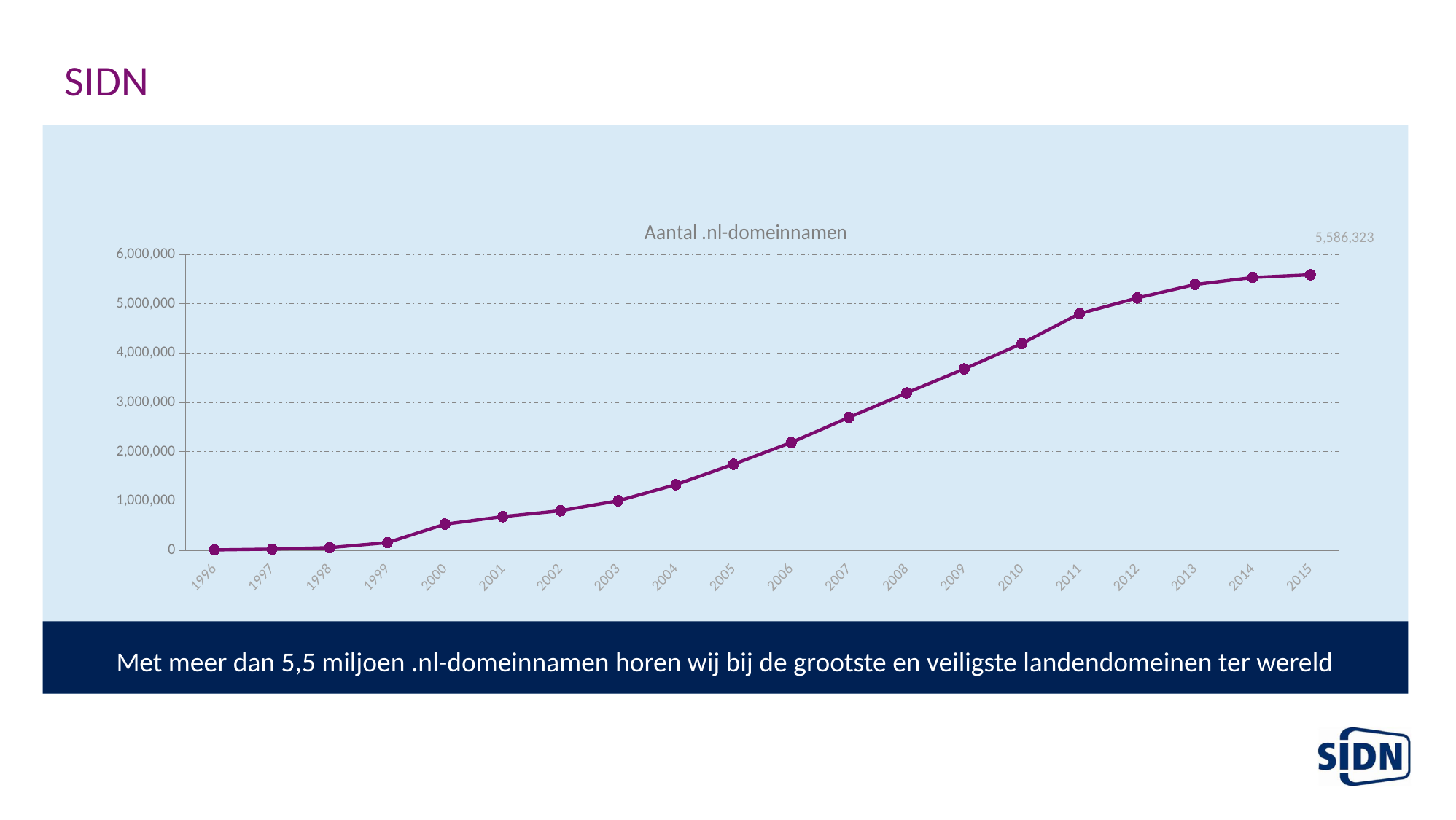
Do the values rise or fall from 1996 to 2015? rise Is the value for 2000 greater or less than 1,000,000? less Which year has the highest value? 2015 Is the value for 2012 greater or less than 5,000,000? greater Which year has the lowest value? 1996 Which is larger, the value for 2008 or the value for 2006? 2008 Is the value for 2010 greater or less than 4,000,000? greater What is the value for 2015? 5,586,323 How many years are plotted on the x axis? 20 What kind of chart is shown on the slide? line chart What is the title of the chart? Aantal .nl-domeinnamen